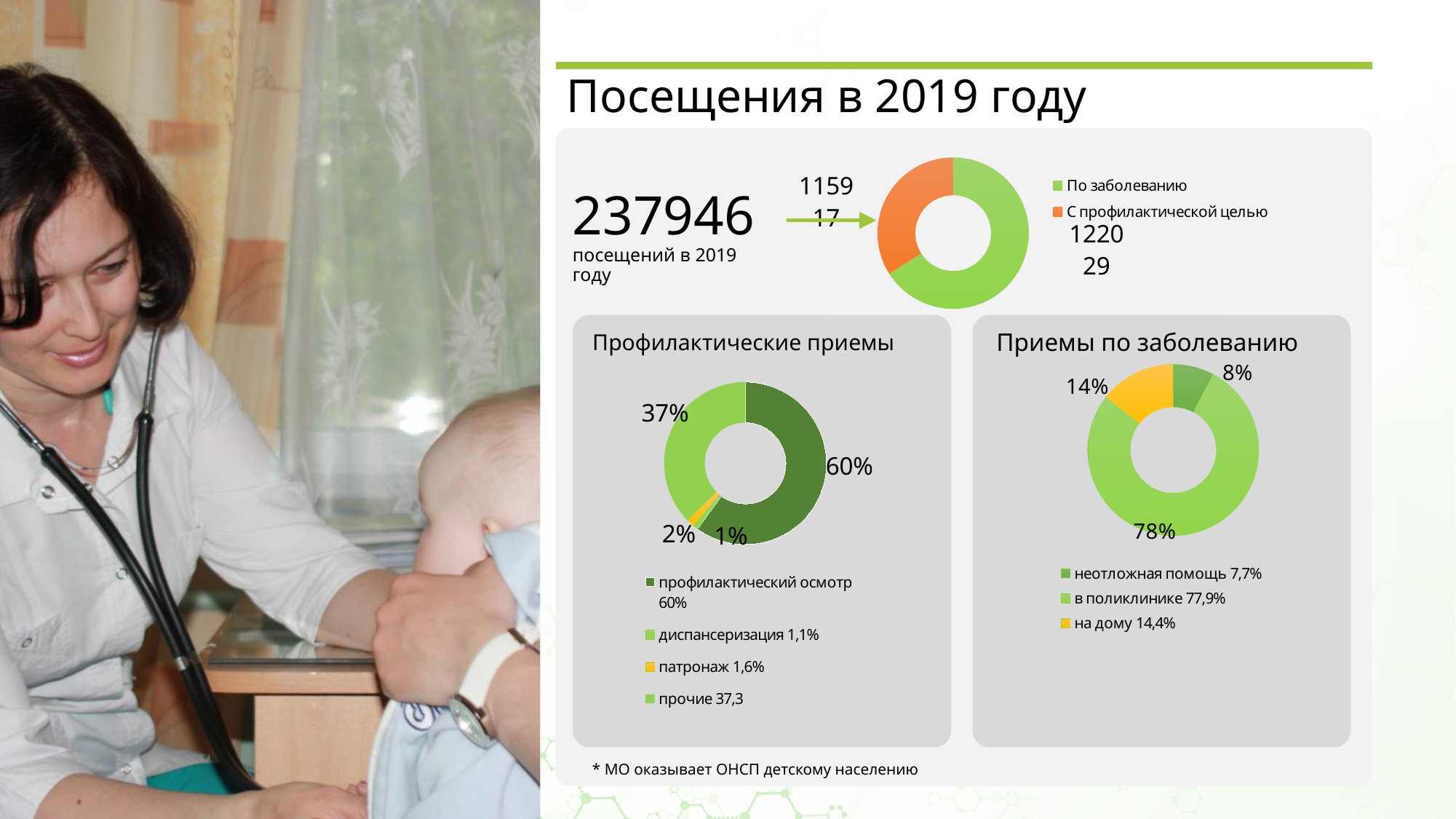
In the 'Профилактические приемы' chart, which is larger: патронаж or диспансеризация? патронаж In the 'Приемы по заболеванию' chart, what share is shown for в поликлинике? 78% What kind of chart is used for 'Профилактические приемы'? pie (donut) chart In the 'Профилактические приемы' chart, which category has the smallest share? диспансеризация In the 'Профилактические приемы' chart, which category has the largest share? профилактический осмотр What total number of visits in 2019 is shown next to the top chart? 237946 In the 'Приемы по заболеванию' chart, what share is shown for на дому? 14% In the 'Приемы по заболеванию' chart, which category has the smallest share? неотложная помощь In the 'Приемы по заболеванию' chart, what is the difference between the data labels for в поликлинике and на дому? 64% How many categories does the legend of the top donut chart list? 2 In the 'Профилактические приемы' chart, what share is shown for профилактический осмотр? 60% How many entries does the legend of the 'Профилактические приемы' chart list? 4